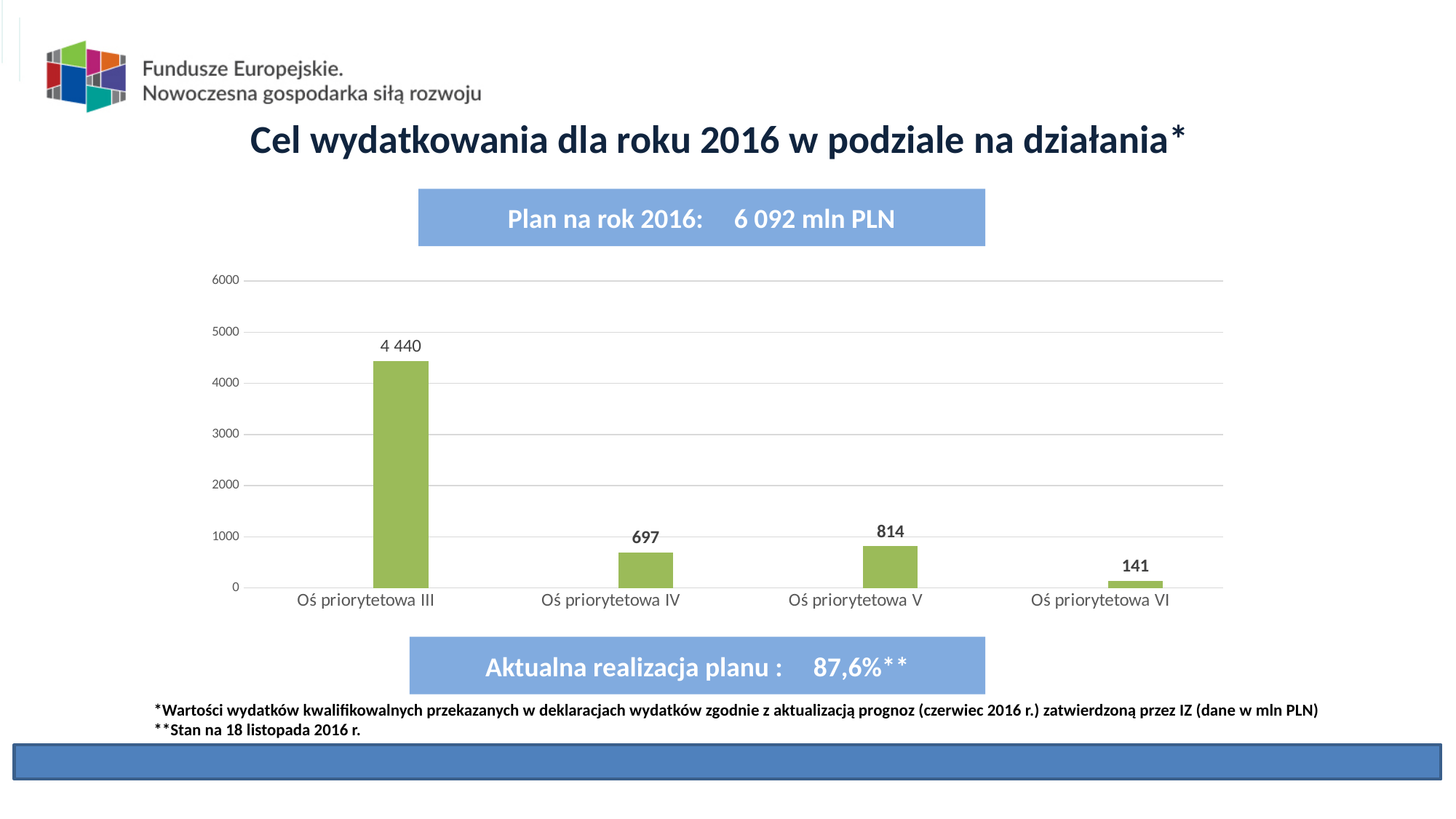
Is the value for Oś priorytetowa III greater or less than 4000? greater What is the value for Oś priorytetowa III? 4 440 How many categories are shown on the x axis? 4 What is the value for Oś priorytetowa V? 814 Which category has the lowest value? Oś priorytetowa VI Which category has the highest value? Oś priorytetowa III What kind of chart is shown on the slide? bar chart What is the value for Oś priorytetowa VI? 141 What is the difference between the values for Oś priorytetowa V and Oś priorytetowa IV? 117 Which is larger, the value for Oś priorytetowa IV or Oś priorytetowa V? Oś priorytetowa V What is the value for Oś priorytetowa IV? 697 What is the plan for 2016 stated in the box above the chart? 6 092 mln PLN